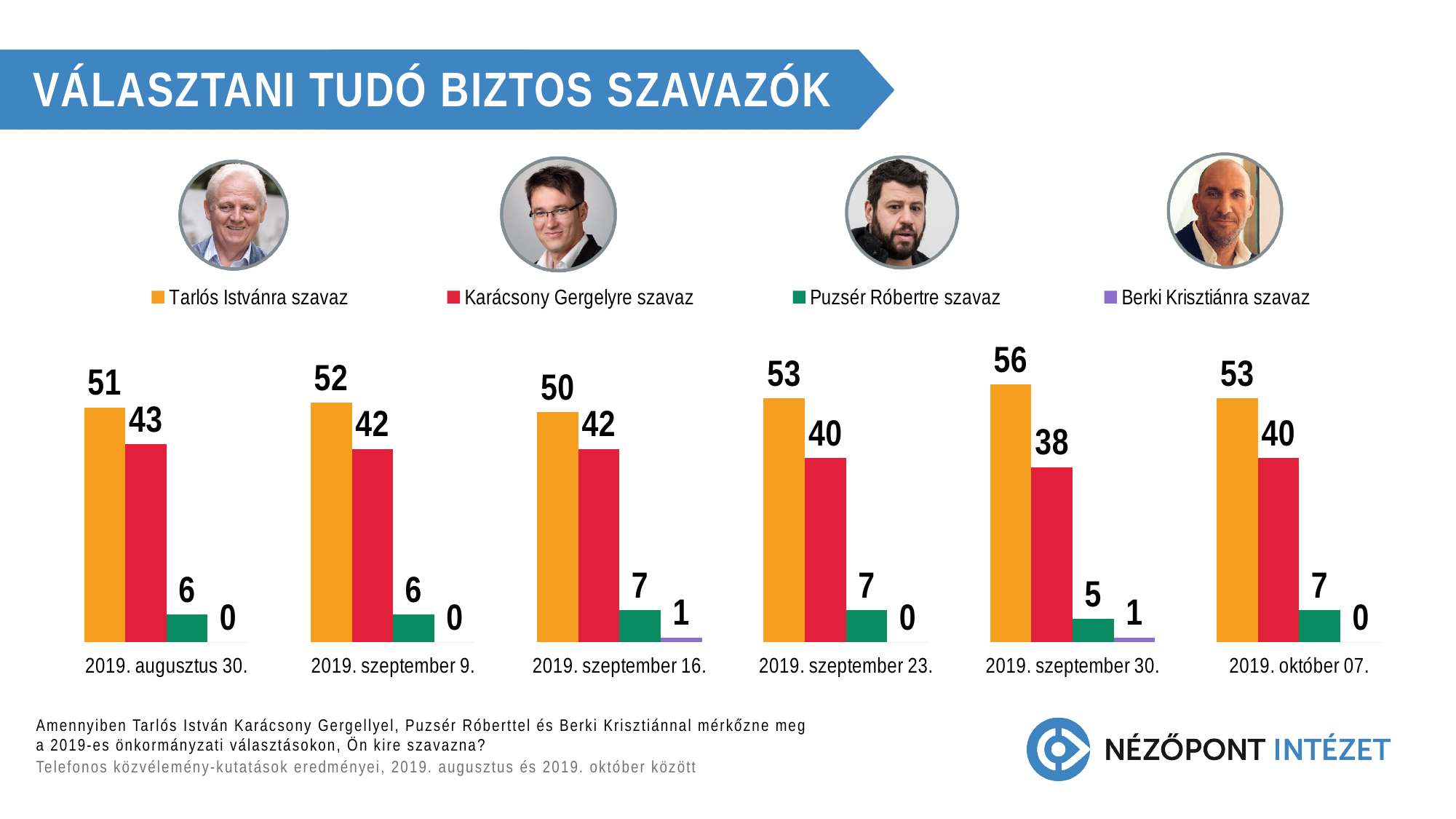
On which date is the value for Tarlós Istvánra szavaz highest? 2019. szeptember 30. How many series does the legend list? 4 What is the value for Karácsony Gergelyre szavaz on 2019. augusztus 30.? 43 How many dates are shown on the x axis of the chart? 6 What is the value for Puzsér Róbertre szavaz on 2019. szeptember 16.? 7 What is the value for Berki Krisztiánra szavaz on 2019. október 07.? 0 What is the difference between Tarlós Istvánra szavaz and Karácsony Gergelyre szavaz on 2019. szeptember 30.? 18 On which date is the value for Karácsony Gergelyre szavaz lowest? 2019. szeptember 30. What is the title of the slide? VÁLASZTANI TUDÓ BIZTOS SZAVAZÓK What kind of chart is shown on the slide? bar chart Which is larger on 2019. szeptember 9.: Tarlós Istvánra szavaz or Karácsony Gergelyre szavaz? Tarlós Istvánra szavaz What is the value for Tarlós Istvánra szavaz on 2019. szeptember 30.? 56